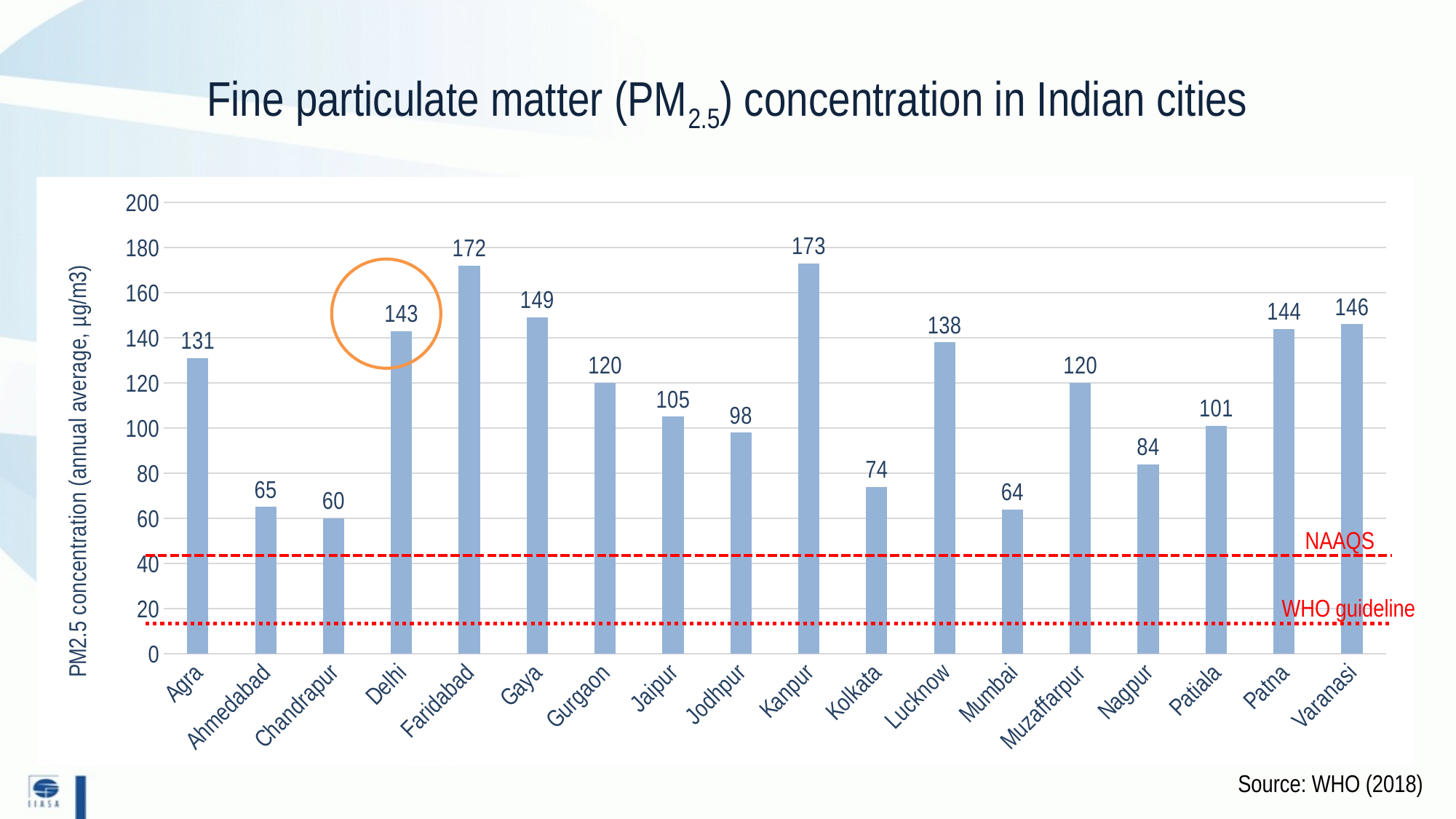
Which city has a higher PM2.5 concentration, Lucknow or Patna? Patna What is the PM2.5 concentration for Varanasi? 146 What kind of chart is shown on the slide? Bar chart How many cities are shown on the chart? 18 Which city has the lowest PM2.5 concentration? Chandrapur What is the difference between the PM2.5 concentrations of Delhi and Agra? 12 What is the PM2.5 concentration for Delhi? 143 What is the PM2.5 concentration for Kolkata? 74 Which city has the highest PM2.5 concentration? Kanpur Which city has a higher PM2.5 concentration, Jaipur or Jodhpur? Jaipur What is the difference between the PM2.5 concentrations of Faridabad and Gaya? 23 What are the two reference lines drawn across the chart labelled? NAAQS and WHO guideline